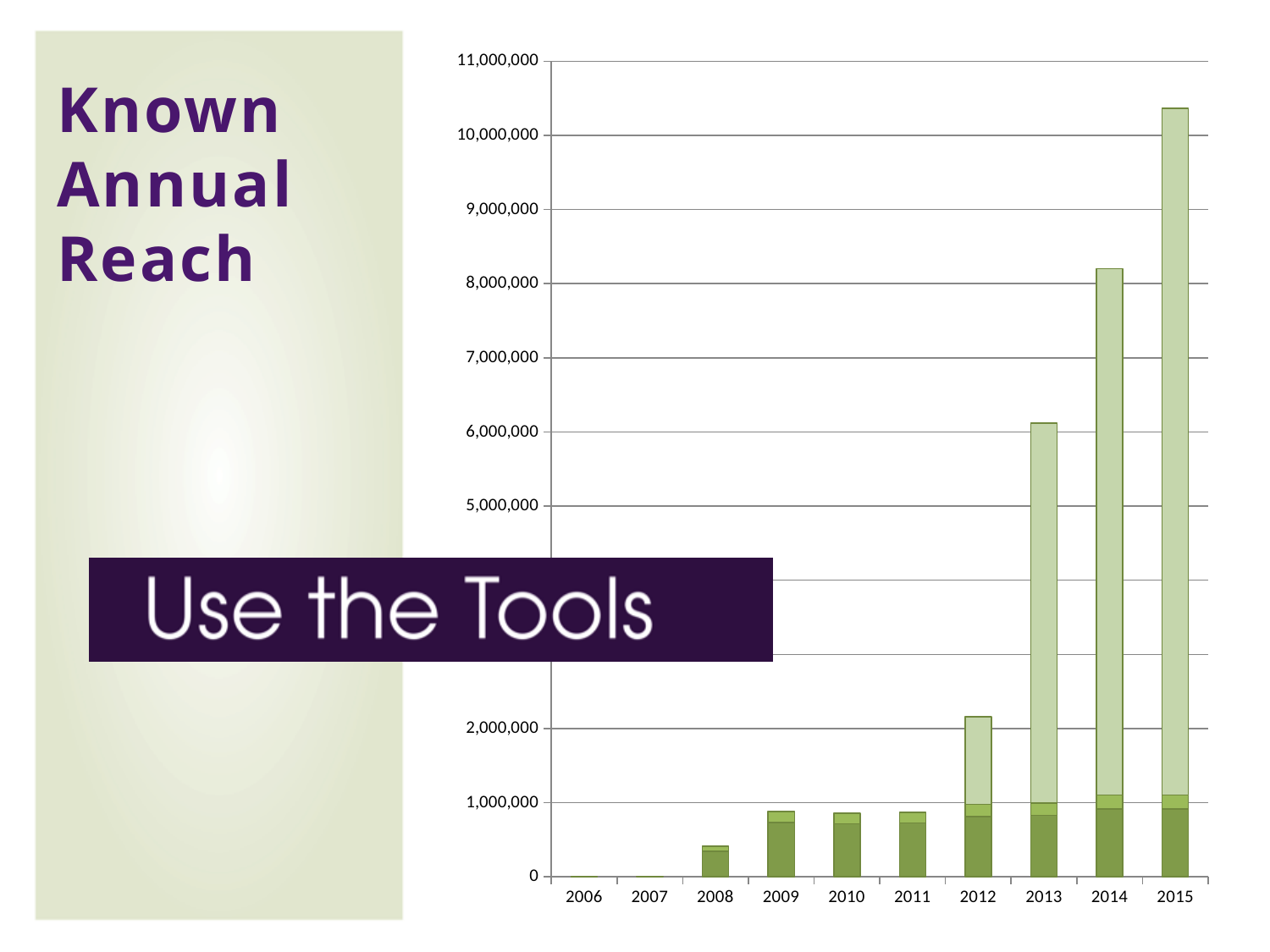
What is the title shown on the left of the slide for this chart? Known Annual Reach Which year has the larger total bar, 2008 or 2009? 2009 Which year has the larger total bar, 2014 or 2015? 2015 Do the total values generally rise or fall from 2006 to 2015? rise Is the total value for 2012 greater or less than 3,000,000? less Which year has the highest total bar in the chart? 2015 Is the total value for 2014 greater or less than 9,000,000? less How many years are shown along the x axis of the chart? 10 Is the total value for 2009 greater or less than 1,000,000? less What kind of chart is shown on the slide? Stacked bar chart